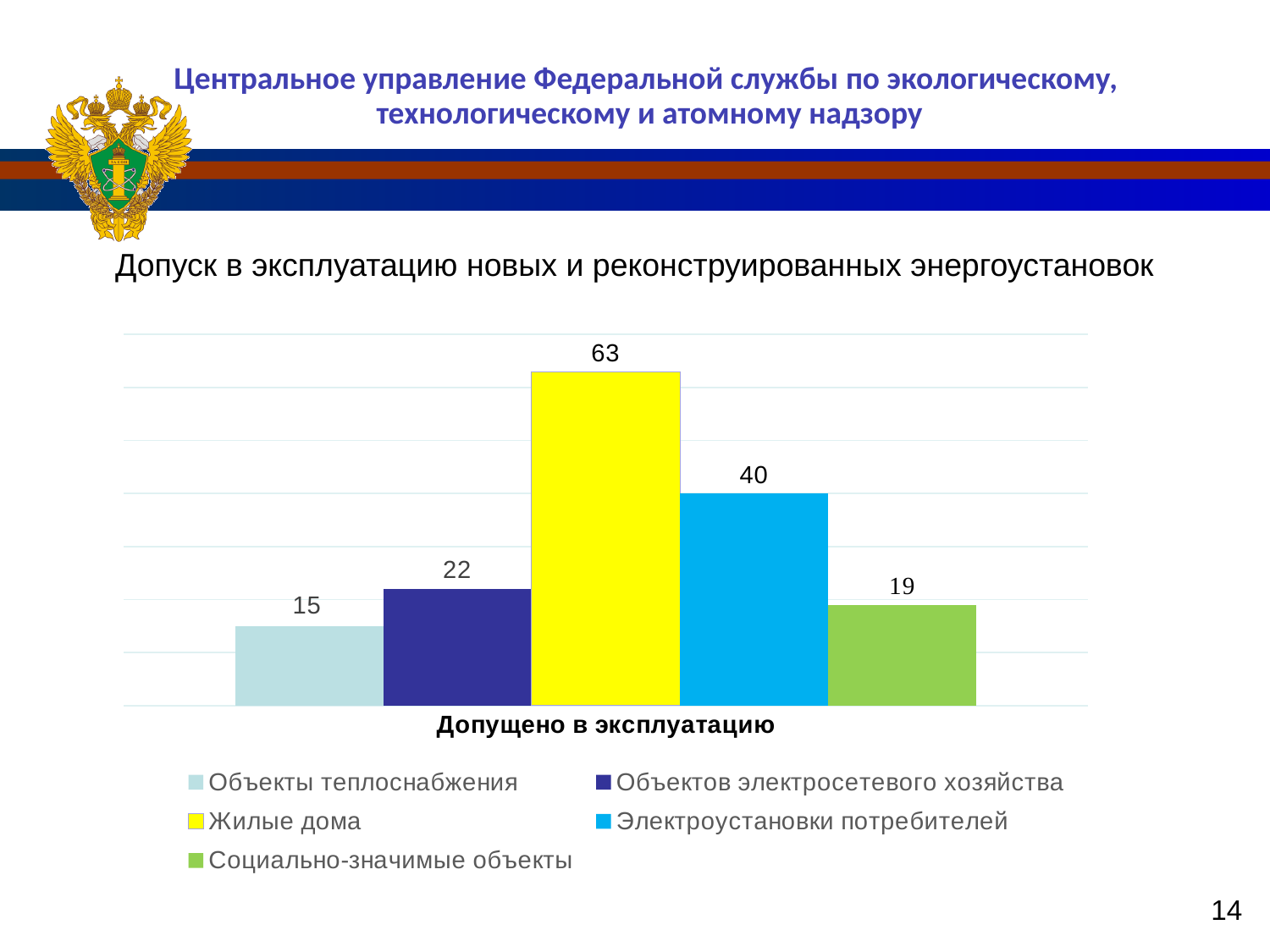
What value is shown for Жилые дома? 63 How many series does the legend list? 5 Which is larger: the value for Объектов электросетевого хозяйства or the value for Социально-значимые объекты? Объектов электросетевого хозяйства What colour is the bar for Жилые дома? Yellow What value is shown for Объекты теплоснабжения? 15 What value is shown for Социально-значимые объекты? 19 What value is shown for Электроустановки потребителей? 40 What is the category label shown on the x axis? Допущено в эксплуатацию What kind of chart is shown on the slide? Bar chart Which series has the lowest value? Объекты теплоснабжения Which series has the highest value? Жилые дома What is the difference between the values for Жилые дома and Электроустановки потребителей? 23